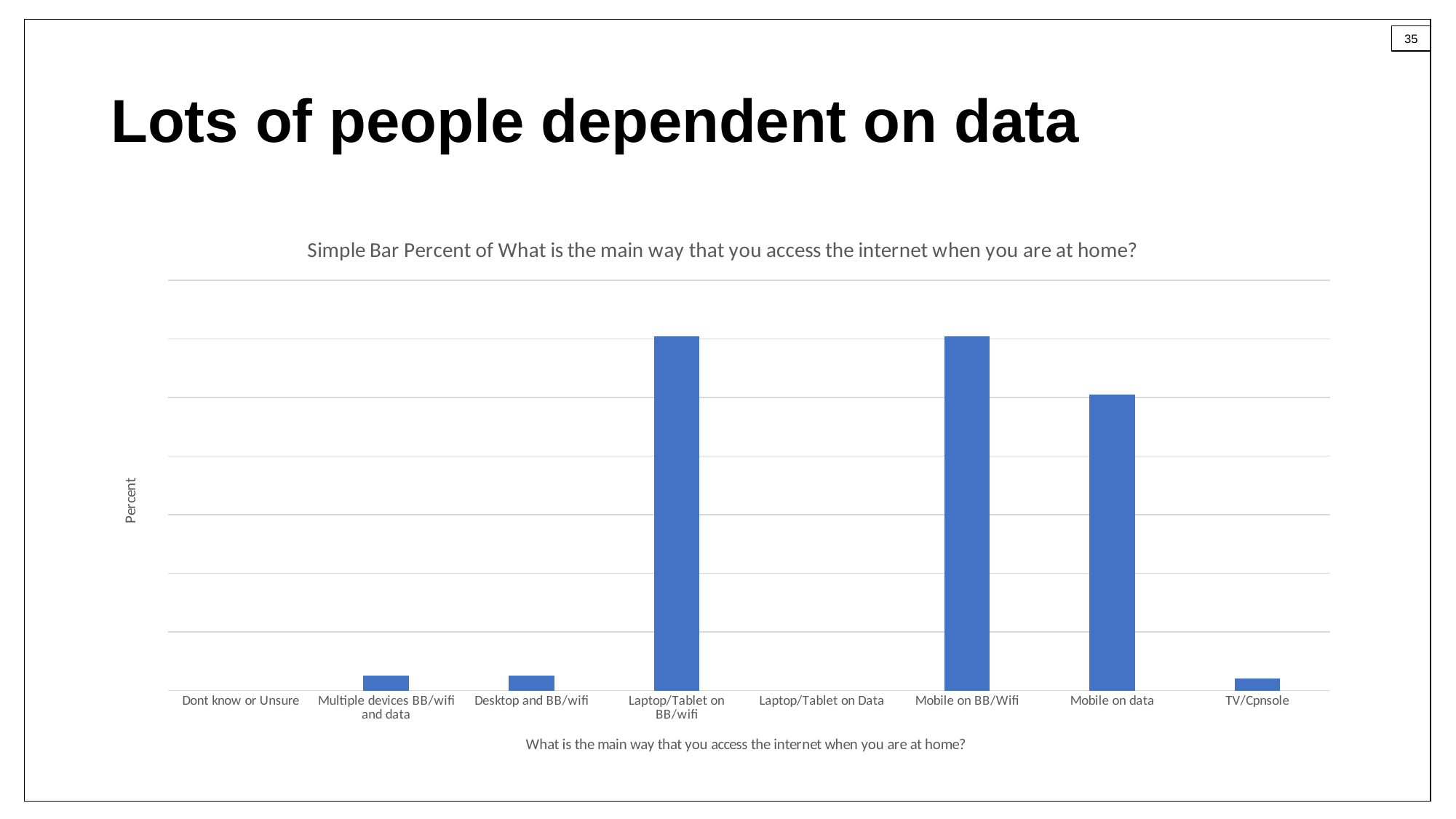
What is the title of the chart? Simple Bar Percent of What is the main way that you access the internet when you are at home? Which categories show no visible bar in the chart? Dont know or Unsure and Laptop/Tablet on Data Which is larger, the value for Multiple devices BB/wifi and data or the value for Mobile on data? Mobile on data Which is larger, the value for Laptop/Tablet on Data or the value for TV/Cpnsole? TV/Cpnsole Which is larger, the value for Laptop/Tablet on BB/wifi or the value for Mobile on data? Laptop/Tablet on BB/wifi How many categories are shown along the x axis of the chart? 8 What kind of chart is shown on the slide? Bar chart What is the label on the vertical axis of the chart? Percent